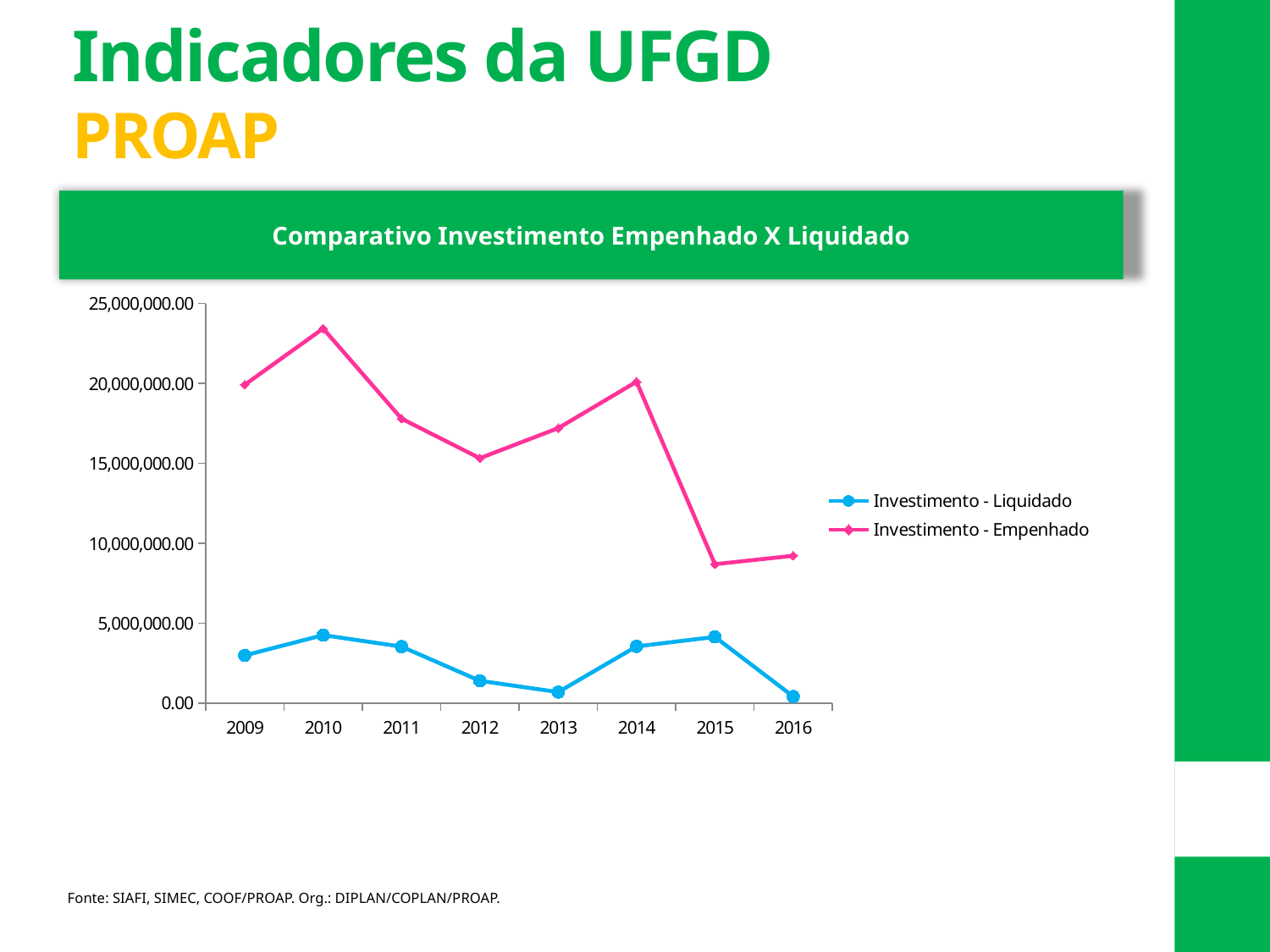
In which year is Investimento - Empenhado highest? 2010 Is the value for Investimento - Liquidado in 2010 greater or less than 5,000,000.00? less In which year is Investimento - Empenhado lowest? 2015 What is the title of the chart? Comparativo Investimento Empenhado X Liquidado What kind of chart is shown on the slide? line chart How many years are plotted along the x axis? 8 Does Investimento - Empenhado rise or fall from 2014 to 2015? fall Which is larger: Investimento - Empenhado in 2009 or in 2015? 2009 How many series does the legend list? 2 Is the value for Investimento - Empenhado in 2015 greater or less than 10,000,000.00? less Is the value for Investimento - Empenhado in 2010 greater or less than 20,000,000.00? greater In which year is Investimento - Liquidado lowest? 2016